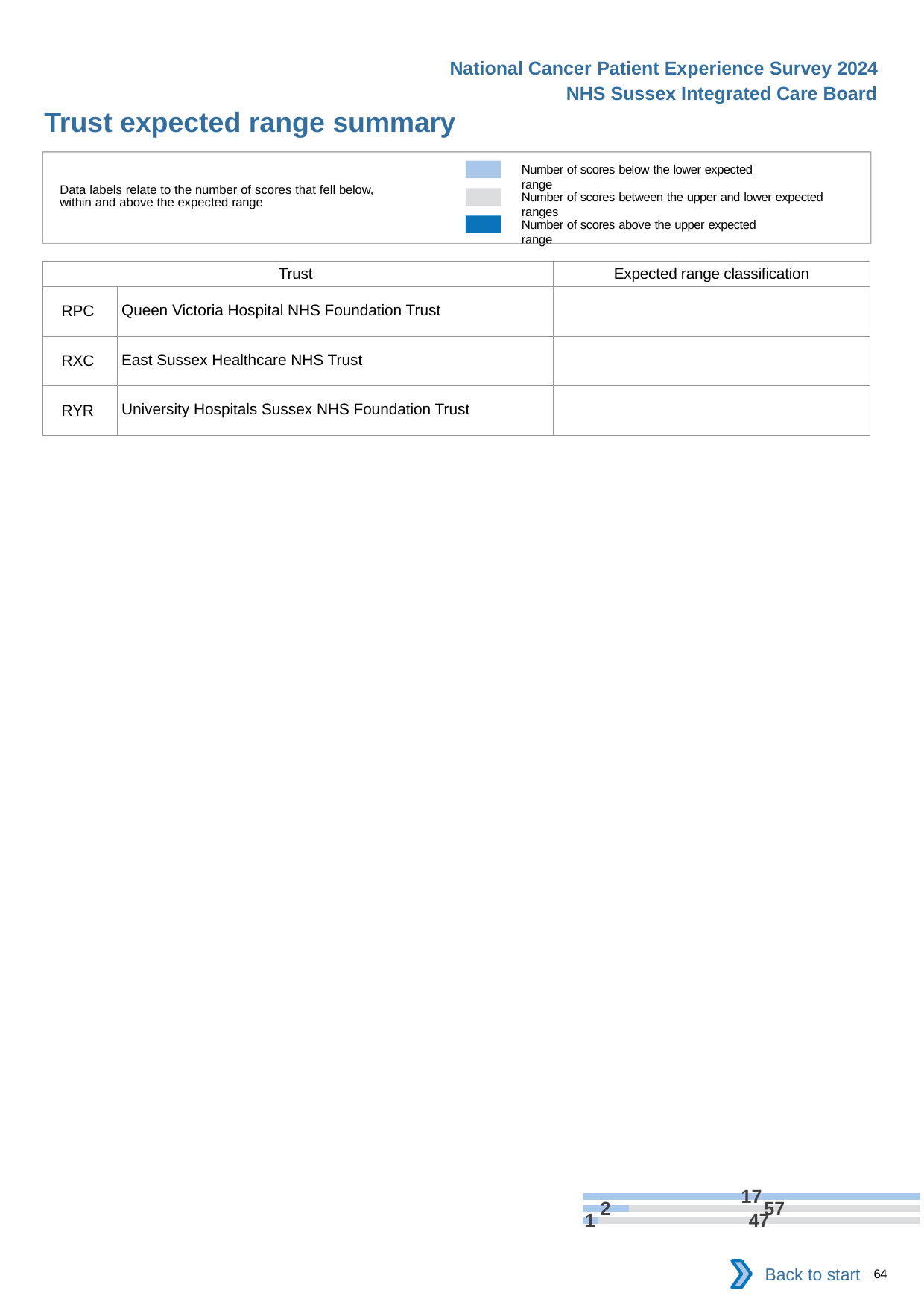
Which colour in the legend represents the number of scores between the upper and lower expected ranges? grey What is the largest data label printed on the chart at the bottom of the slide? 57 What is the smallest data label printed on the chart at the bottom of the slide? 1 Which colour in the legend represents the number of scores above the upper expected range? dark blue What kind of chart is shown at the bottom of the slide? bar chart How many series does the legend at the top of the slide list? 3